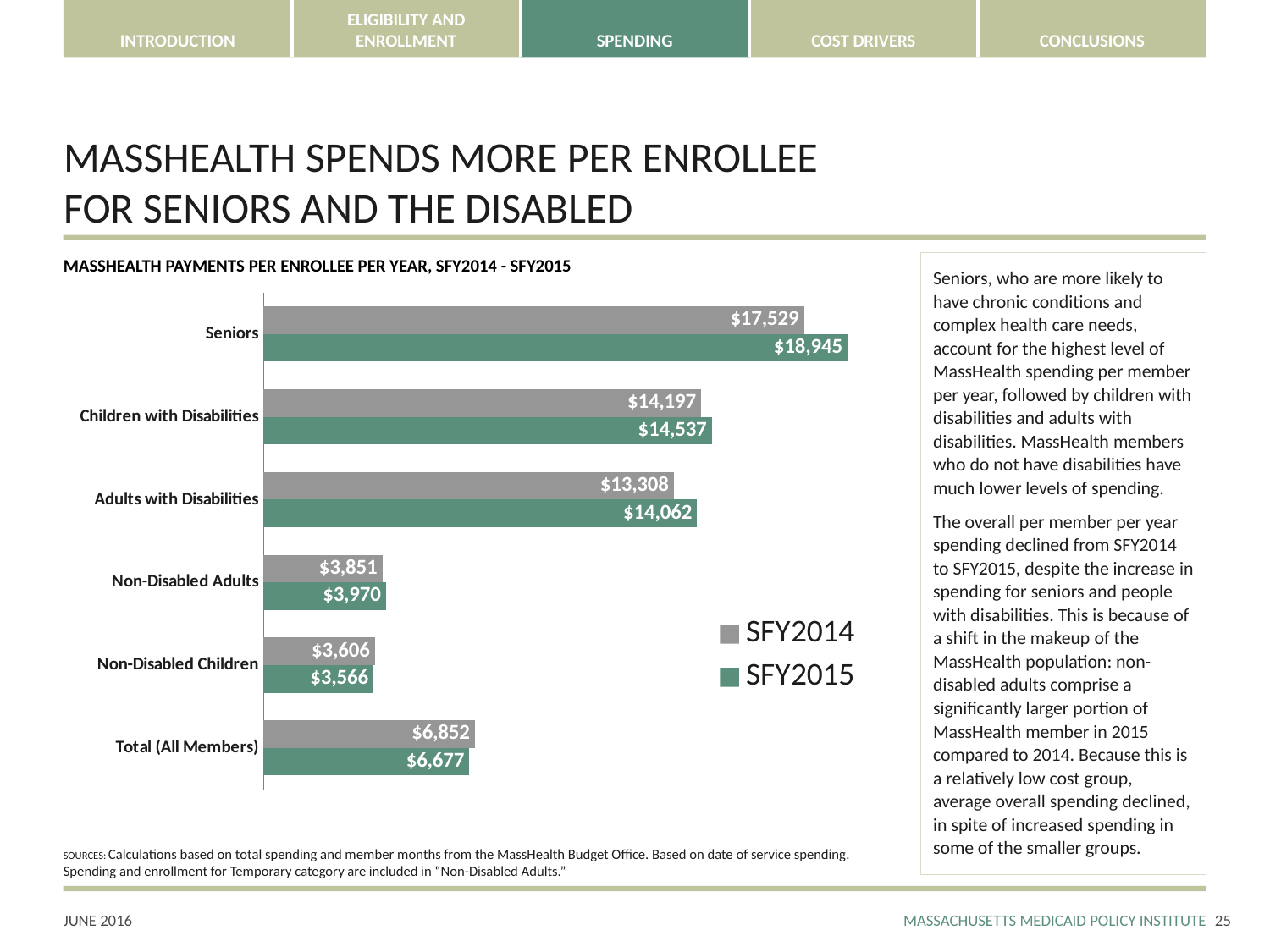
What type of chart is shown on the slide? Bar chart What is the difference between the SFY2014 and SFY2015 payments per enrollee for Total (All Members)? $175 How many series does the legend list? 2 Which was larger for Adults with Disabilities: the SFY2014 or the SFY2015 payment per enrollee? SFY2015 How many categories are shown on the chart? 6 What was the payment per enrollee for Non-Disabled Children in SFY2015? $3,566 Which category had the lowest payment per enrollee in SFY2014? Non-Disabled Children What was the payment per enrollee for Children with Disabilities in SFY2014? $14,197 What was the MassHealth payment per enrollee per year for Seniors in SFY2015? $18,945 Which category had the highest payment per enrollee in SFY2015? Seniors Which was larger for Non-Disabled Children: the SFY2014 or the SFY2015 payment per enrollee? SFY2014 By how much did the payment per enrollee for Seniors increase from SFY2014 to SFY2015? $1,416